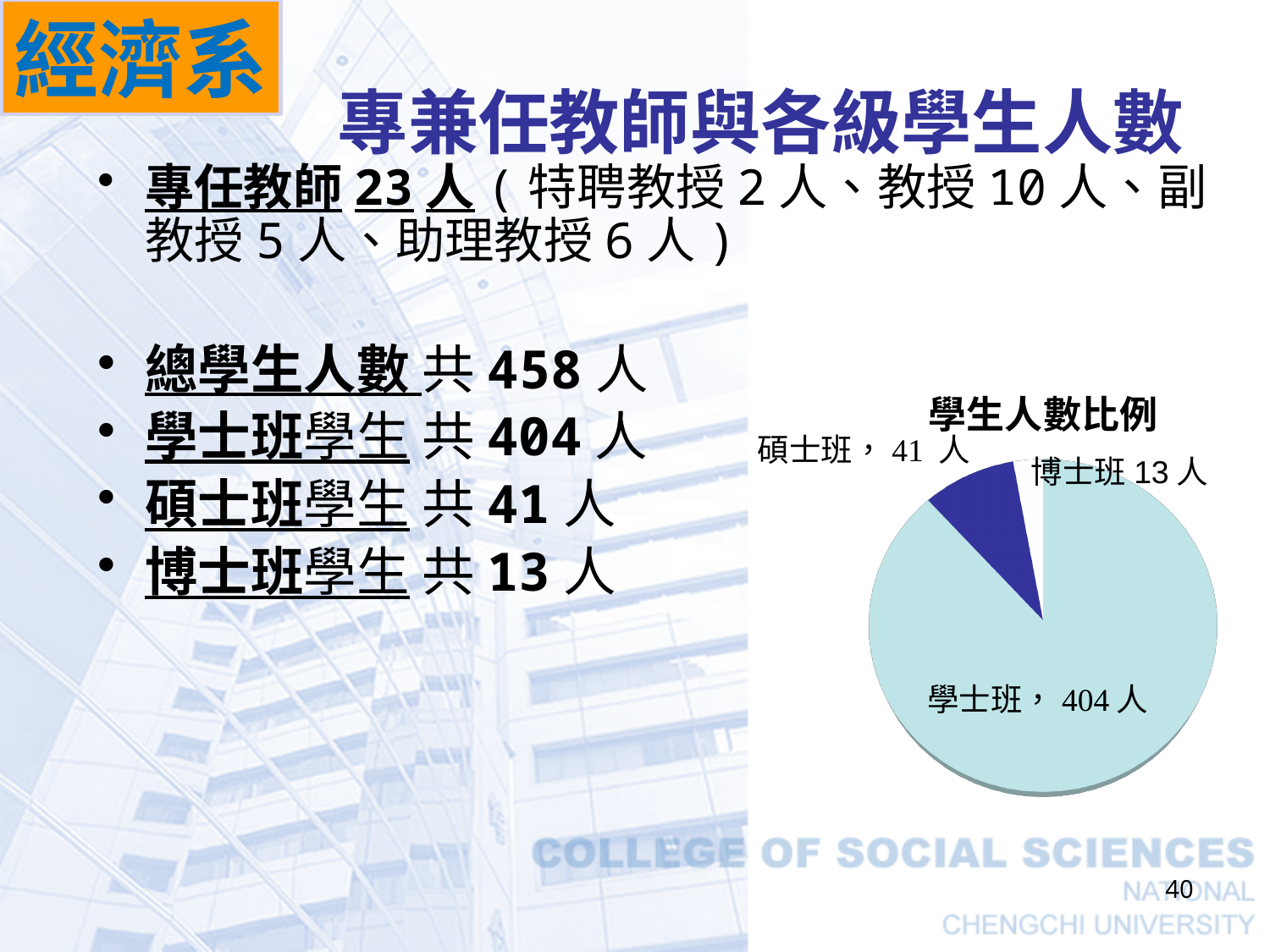
Which category has the largest slice in the pie chart? 學士班 What is the value shown for 學士班 in the pie chart? 404 人 Which category has the smallest slice in the pie chart? 博士班 What is the difference between the 碩士班 and 博士班 values in the pie chart? 28 人 What is the value shown for 碩士班 in the pie chart? 41 人 How many slices does the pie chart have? 3 What is the difference between the 學士班 and 碩士班 values in the pie chart? 363 人 What is the title of the pie chart? 學生人數比例 Which is larger in the pie chart, 碩士班 or 博士班? 碩士班 What type of chart is shown on the slide? pie chart What is the value shown for 博士班 in the pie chart? 13 人 What is the total of all slices in the pie chart? 458 人